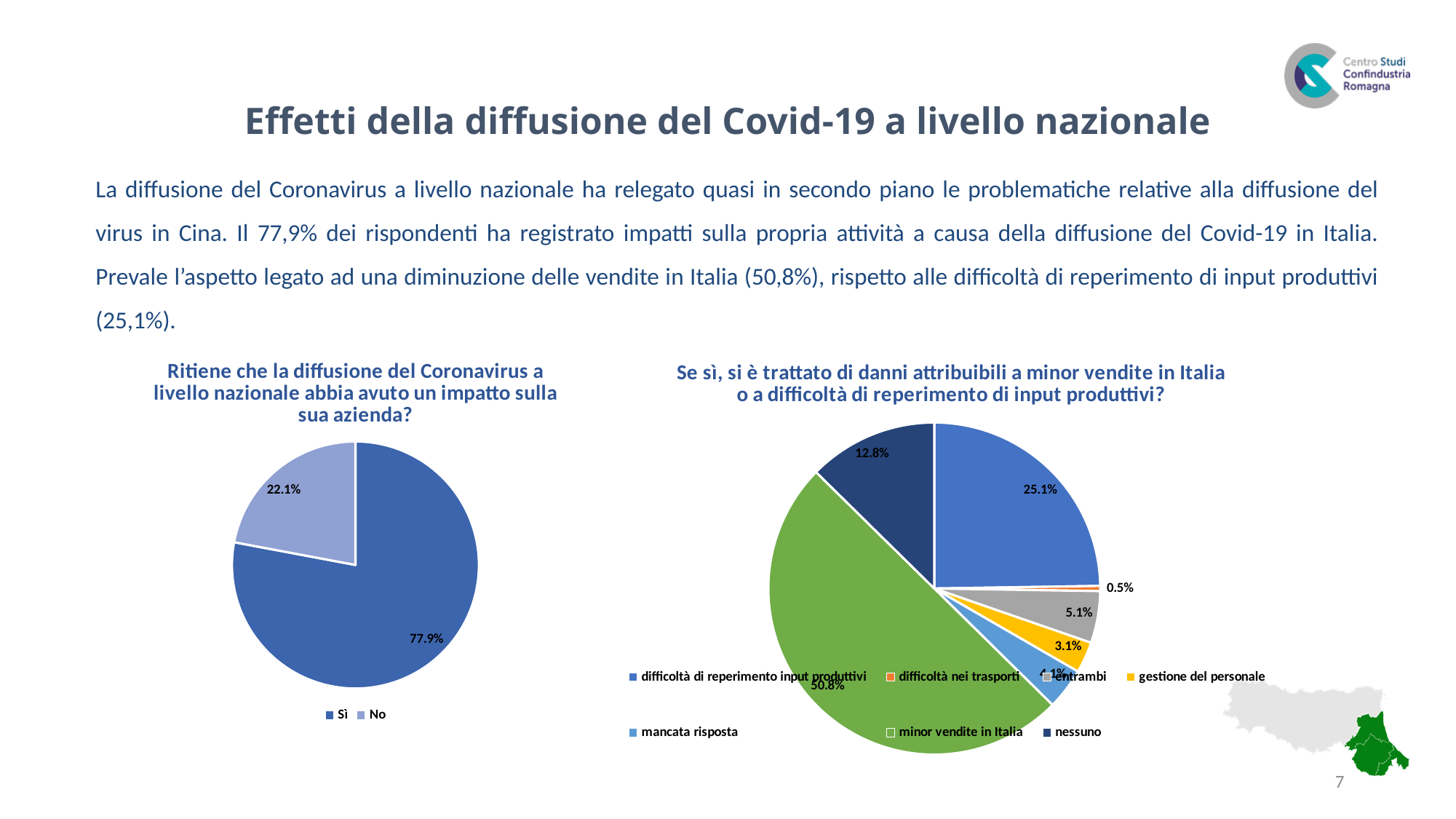
How many categories does the legend of the right pie chart list? 7 In the right pie chart, which category has the largest share? minor vendite in Italia In the right pie chart, what share is attributed to "difficoltà di reperimento input produttivi"? 25.1% In the right pie chart, what share is attributed to "nessuno"? 12.8% In the right pie chart, which category has the smallest share? difficoltà nei trasporti In the left pie chart, what share of respondents answered "Sì"? 77.9% In the right pie chart, what share is attributed to "minor vendite in Italia"? 50.8% In the right pie chart, which is larger: "entrambi" or "gestione del personale"? entrambi In the right pie chart, what is the difference between the shares for "minor vendite in Italia" and "difficoltà di reperimento input produttivi"? 25.7% What kind of chart is the chart on the left of the slide? Pie chart In the left pie chart, what share of respondents answered "No"? 22.1% In the left pie chart, what is the difference between the "Sì" and "No" shares? 55.8%